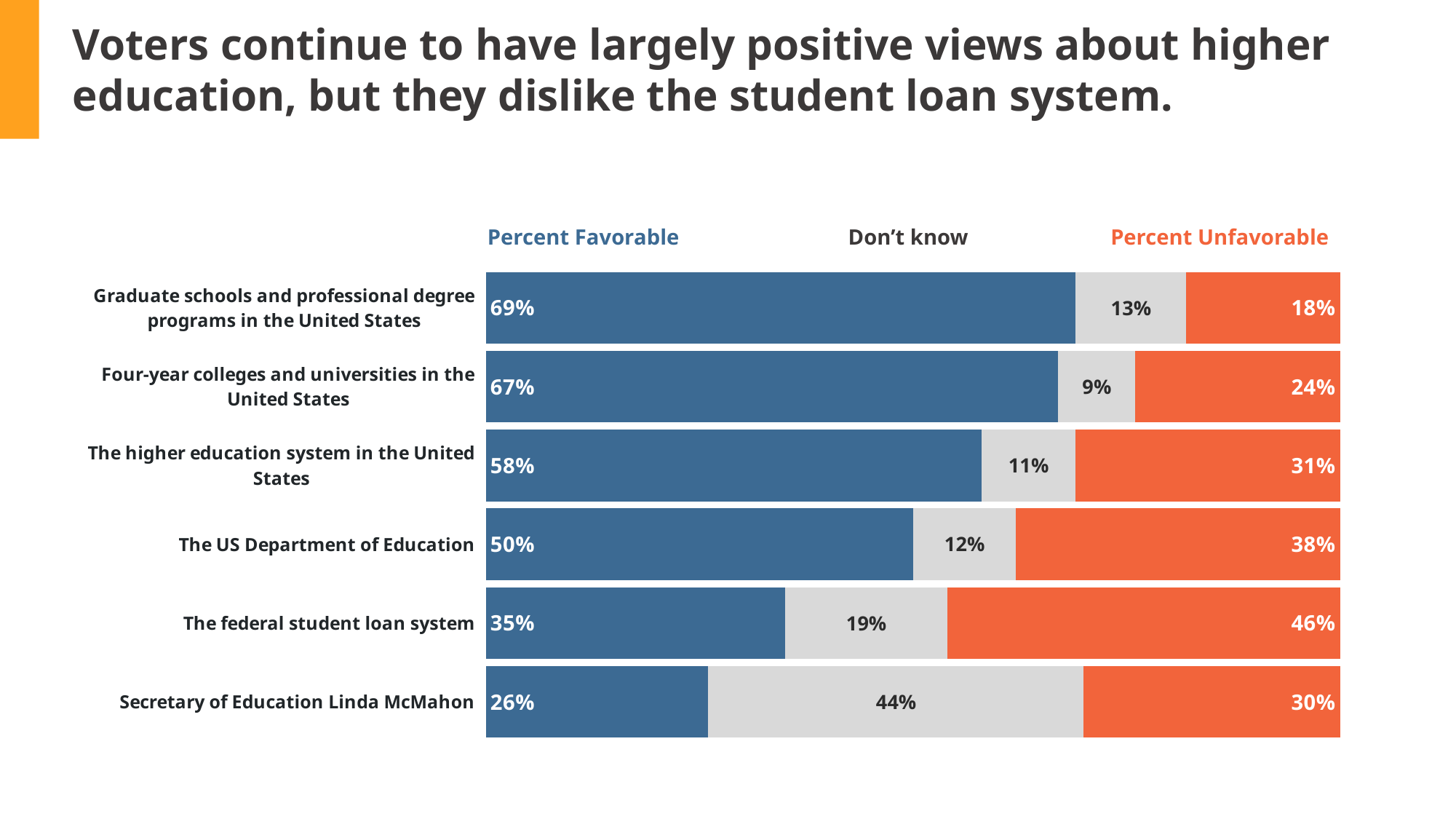
What is the difference between the Percent Favorable and Percent Unfavorable for The US Department of Education? 12% What is the Don't know share for Secretary of Education Linda McMahon? 44% Which category has the highest Percent Favorable? Graduate schools and professional degree programs in the United States Which category has the highest Percent Unfavorable? The federal student loan system What is the Percent Favorable for Four-year colleges and universities in the United States? 67% Which category has the lowest Percent Favorable? Secretary of Education Linda McMahon What colour represents Percent Unfavorable in the chart? Orange What kind of chart is shown on the slide? Stacked bar chart How many series does the chart show? 3 Which is larger: the Percent Unfavorable for The higher education system in the United States or for Secretary of Education Linda McMahon? The higher education system in the United States What is the Percent Unfavorable for The federal student loan system? 46% How many categories are shown in the chart? 6